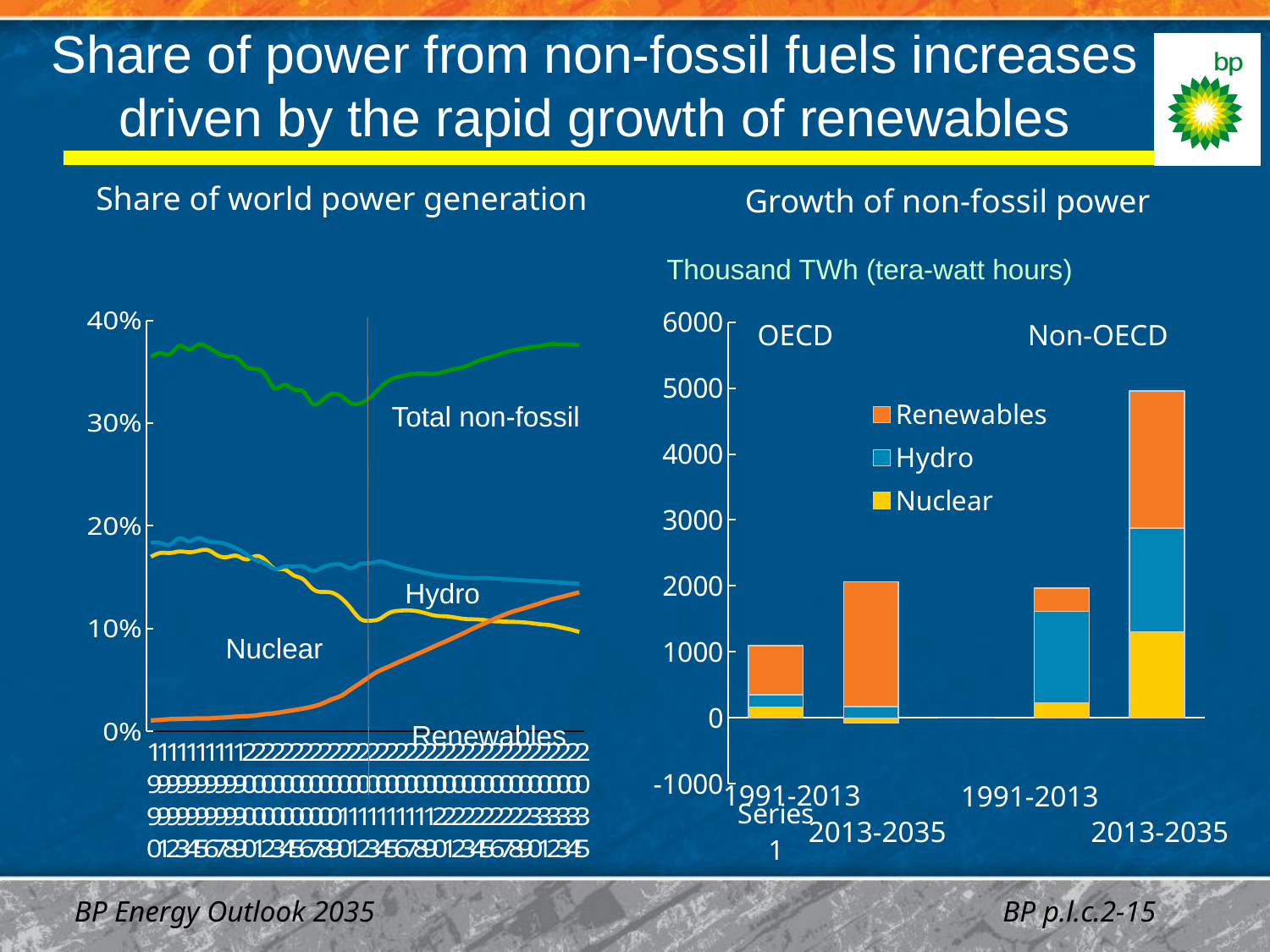
In the 'Growth of non-fossil power' chart, how many series does the legend list? 3 In the 'Growth of non-fossil power' chart, is the total for OECD 1991-2013 greater or less than 2000? less In the 'Growth of non-fossil power' chart, which bar has the lowest total? OECD 1991-2013 In the 'Growth of non-fossil power' chart, how many bars are plotted? 4 In the 'Growth of non-fossil power' chart, which bar is taller: OECD 2013-2035 or Non-OECD 2013-2035? Non-OECD 2013-2035 In the 'Share of world power generation' chart, does the Nuclear line rise or fall over time? Falls What kind of chart is the 'Share of world power generation' chart on the left? Line chart In the 'Share of world power generation' chart, is the Total non-fossil line ever below 30%? No In the 'Growth of non-fossil power' chart, is the total for Non-OECD 2013-2035 greater or less than 4000? greater What kind of chart is the 'Growth of non-fossil power' chart on the right? Stacked bar chart In the 'Growth of non-fossil power' chart, which bar has the highest total? Non-OECD 2013-2035 In the 'Share of world power generation' chart, does the Renewables line rise or fall over time? Rises